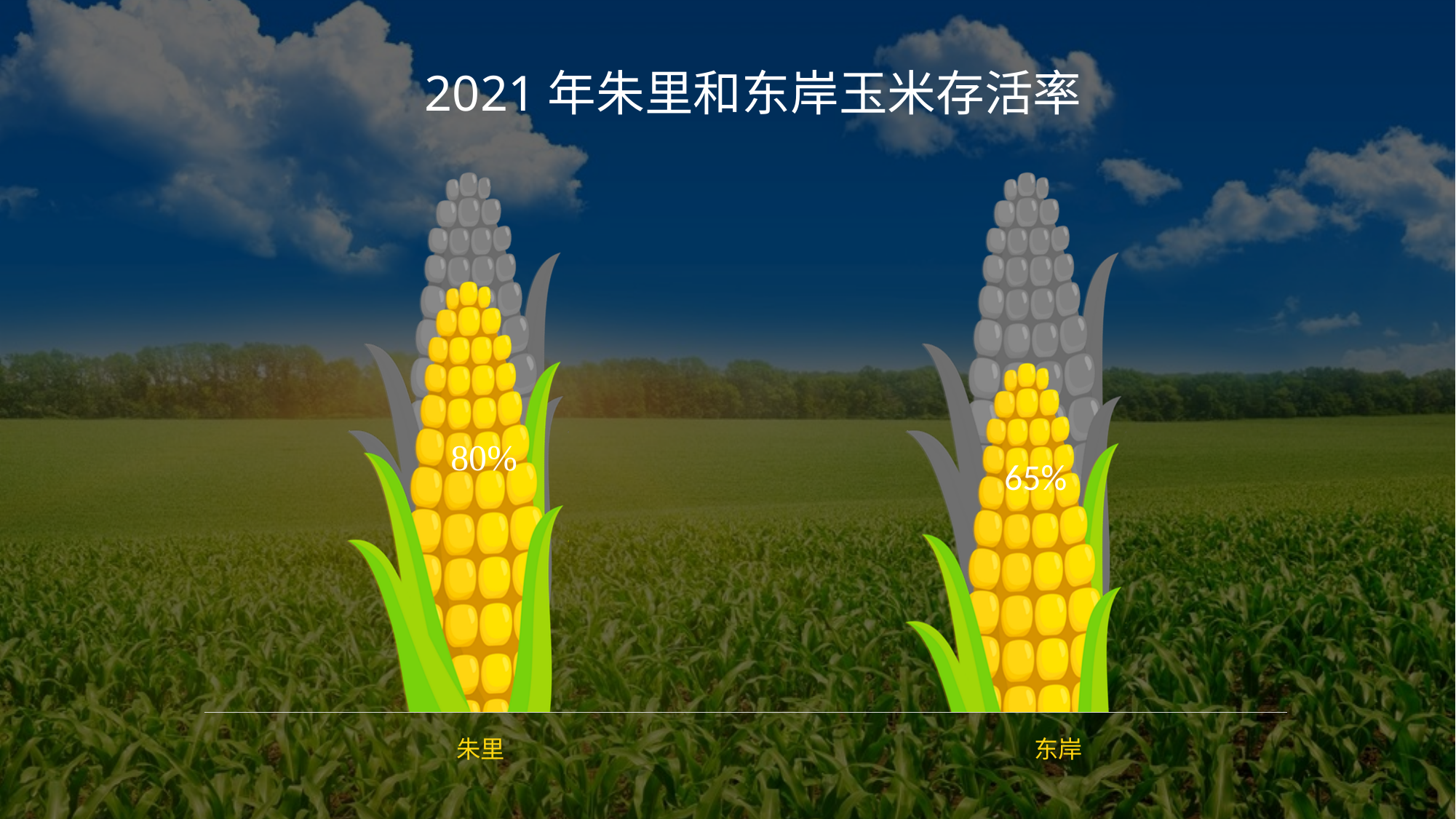
What is the corn survival rate for 朱里? 80% How many locations are shown in the chart? 2 Which location has the higher corn survival rate? 朱里 Which location has the lower corn survival rate? 东岸 Is the survival rate for 东岸 larger or smaller than that for 朱里? smaller What kind of chart is shown on the slide? bar chart Which year does the chart's data refer to? 2021 What is the difference between the survival rates of 朱里 and 东岸? 15% What is the corn survival rate for 东岸? 65% What is the title of the chart? 2021 年朱里和东岸玉米存活率